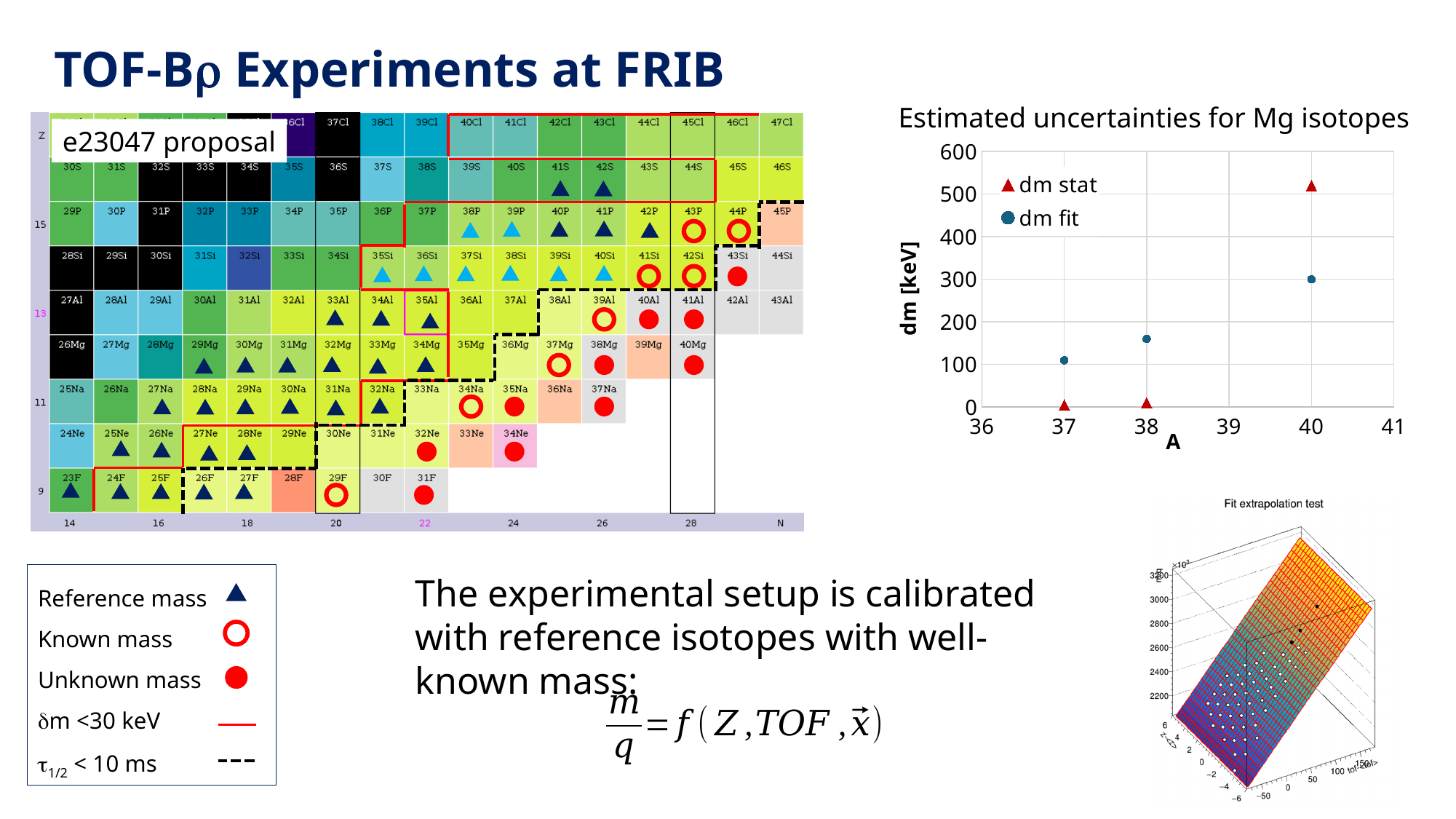
In the 'Estimated uncertainties for Mg isotopes' chart, is the dm fit value at A = 37 greater or less than 200? less In the 'Estimated uncertainties for Mg isotopes' chart, at which value of A is dm fit highest? 40 What are the two legend entries in the 'Estimated uncertainties for Mg isotopes' chart? dm stat and dm fit In the 'Estimated uncertainties for Mg isotopes' chart, is the dm stat value at A = 37 greater or less than 100? less In the 'Estimated uncertainties for Mg isotopes' chart, is the dm fit value at A = 40 greater or less than 200? greater What kind of chart is the 'Estimated uncertainties for Mg isotopes' chart? scatter chart In the 'Estimated uncertainties for Mg isotopes' chart, at how many values of A are data points plotted? 3 In the 'Estimated uncertainties for Mg isotopes' chart, at A = 40, which is larger: dm stat or dm fit? dm stat What is the y-axis label of the 'Estimated uncertainties for Mg isotopes' chart? dm [keV] In the 'Estimated uncertainties for Mg isotopes' chart, at which value of A is dm fit lowest? 37 How many series does the legend of the 'Estimated uncertainties for Mg isotopes' chart list? 2